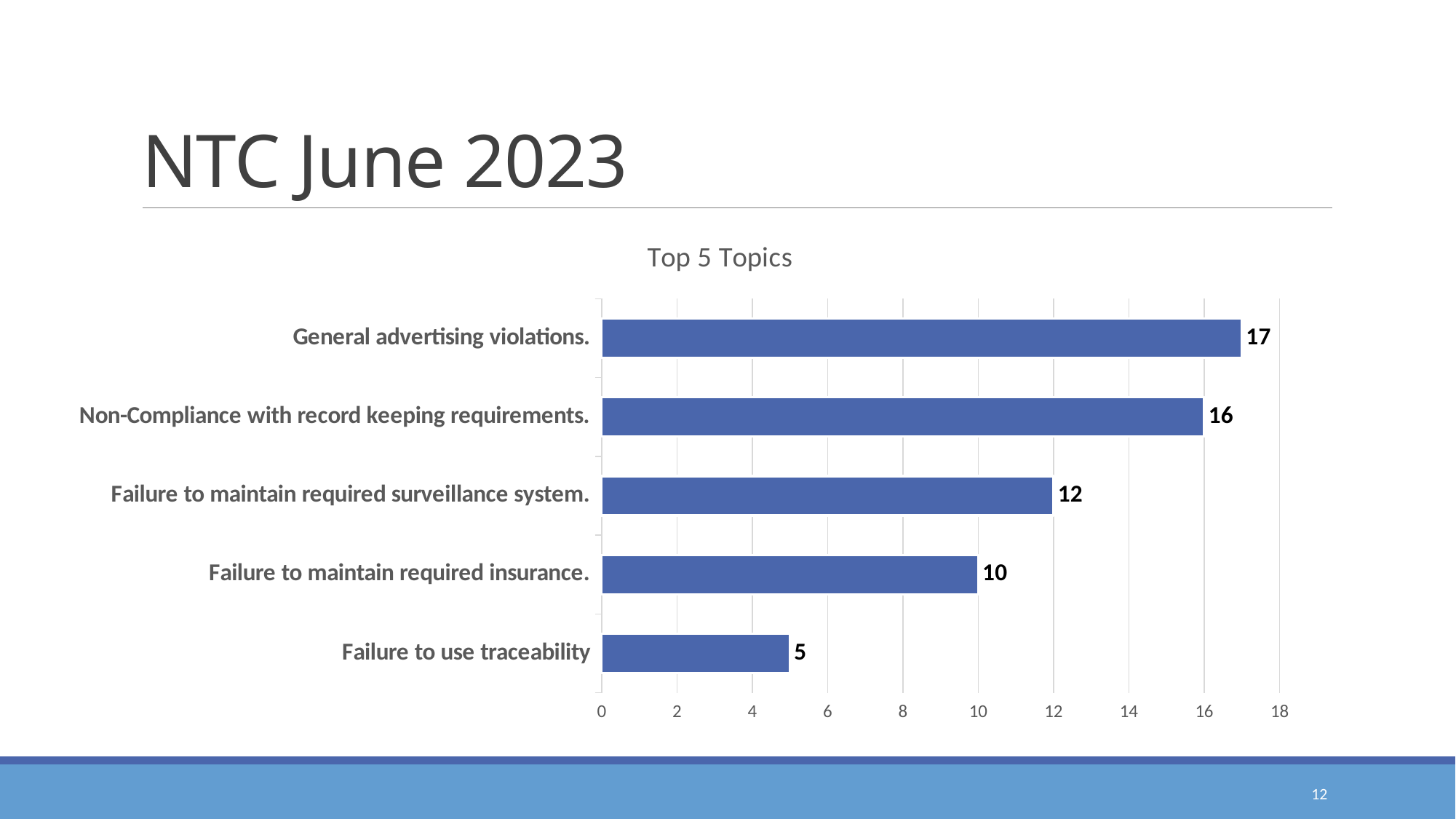
What is the value for Non-Compliance with record keeping requirements? 16 What is the difference between the values for General advertising violations and Failure to maintain required insurance? 7 What is the value for General advertising violations? 17 What is the title of the chart? Top 5 Topics How many topics are shown in the chart? 5 What is the value for Failure to use traceability? 5 What kind of chart is shown on the slide? bar chart Which topic has the lowest value? Failure to use traceability Which topic has the highest value? General advertising violations. Which is larger: the value for Non-Compliance with record keeping requirements or the value for Failure to maintain required surveillance system? Non-Compliance with record keeping requirements. What is the value for Failure to maintain required surveillance system? 12 Is the value for Failure to maintain required insurance greater or less than 8? greater